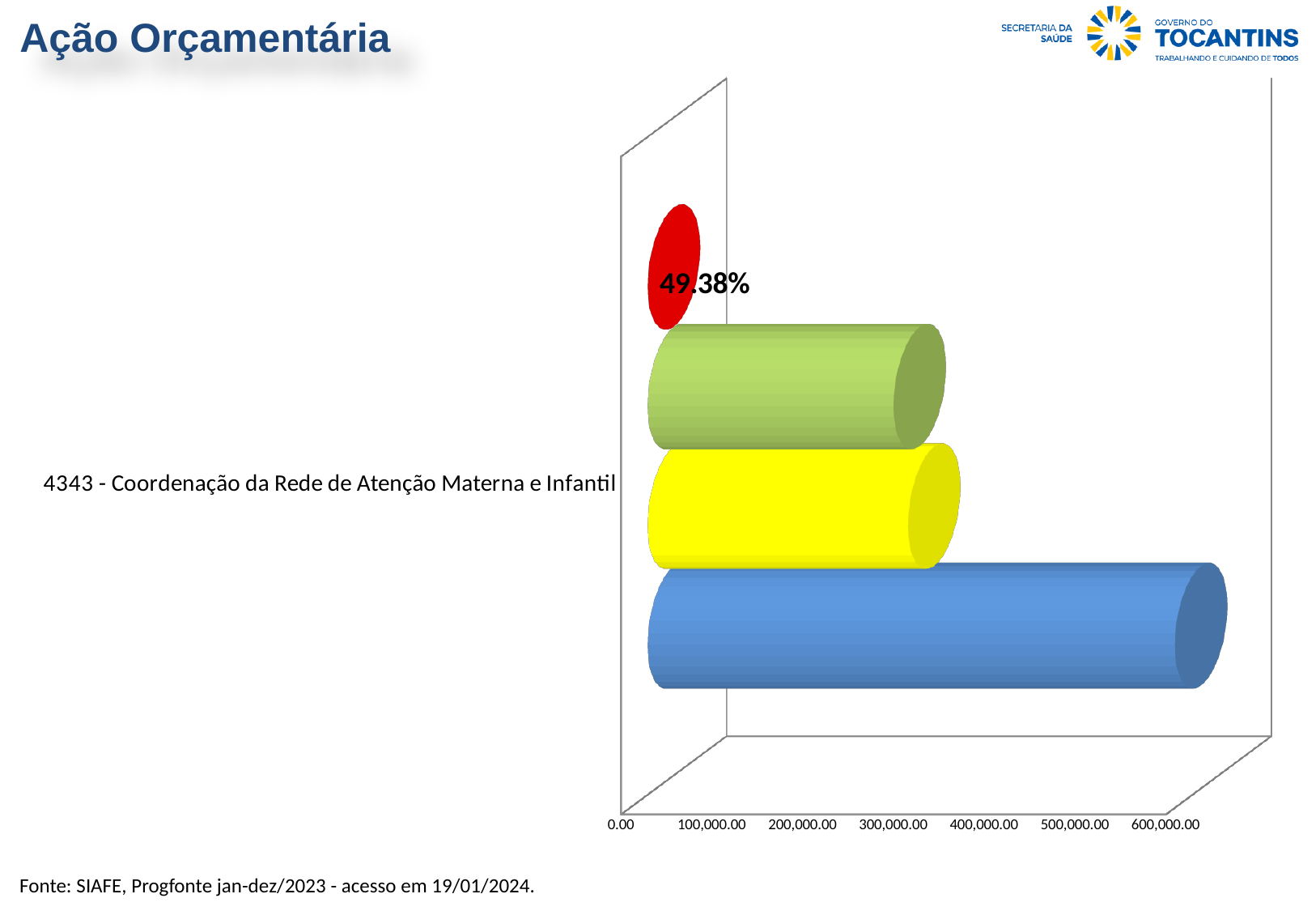
Is the value of the green bar greater or less than 100,000.00? greater What value is printed as a data label on the red bar? 49.38% Which is larger, the blue bar or the green bar? the blue bar How many categories does the chart show? 1 Which bar is the shortest in the chart? the red bar What is the category label shown on the chart? 4343 - Coordenação da Rede de Atenção Materna e Infantil What kind of chart is shown on the slide? bar chart What is the highest tick value shown on the horizontal axis? 600,000.00 Which bar is the longest in the chart? the blue bar Which is larger, the green bar or the red bar? the green bar Is the value of the blue bar greater or less than 300,000.00? greater Is the value of the red bar greater or less than 200,000.00? less